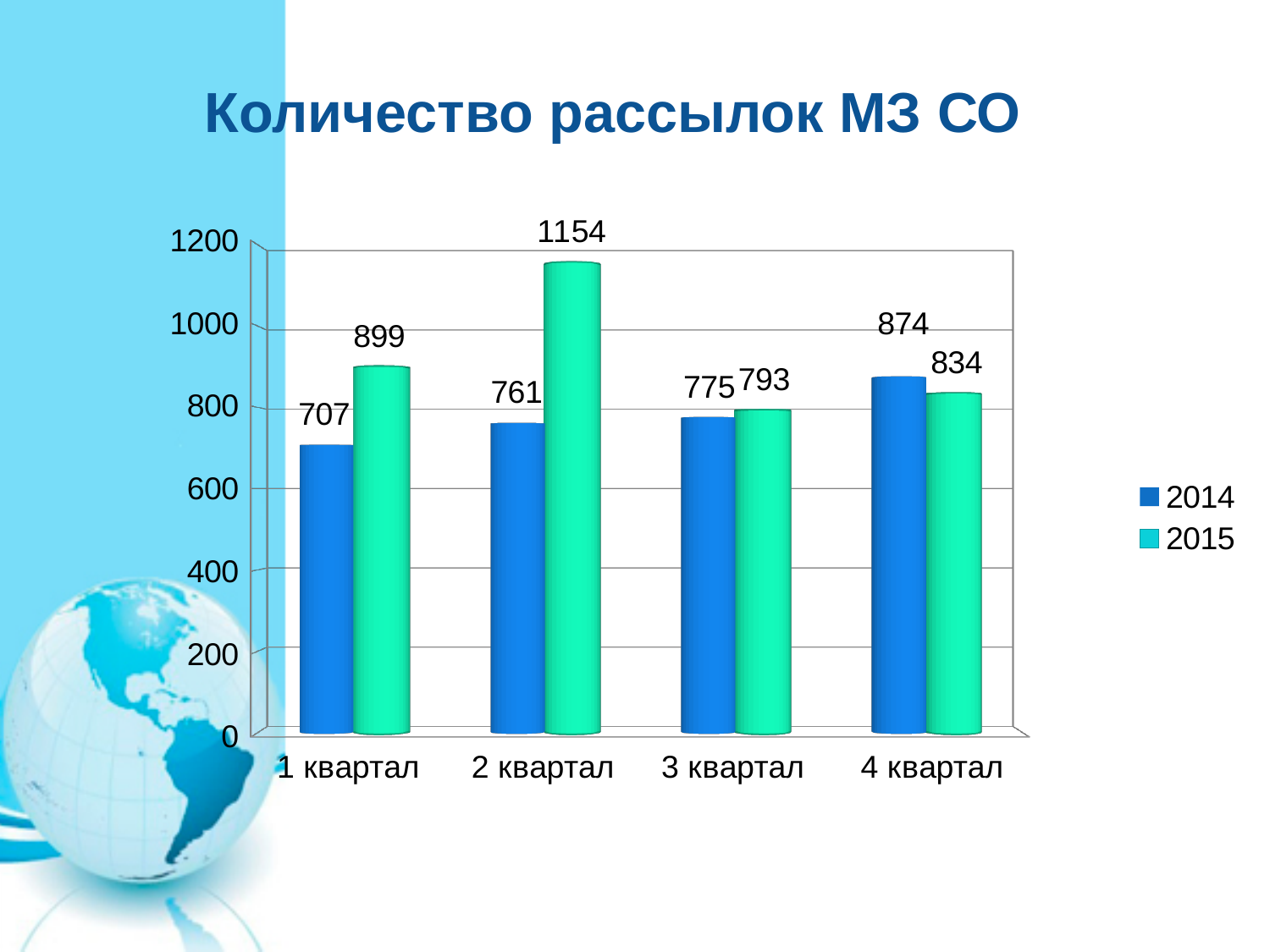
What kind of chart is shown on the slide? Bar chart What is the title of the chart? Количество рассылок МЗ СО What is the value for 2015 in 3 квартал? 793 What is the value for 2015 in 2 квартал? 1154 Which quarter has the lowest value for 2014? 1 квартал What is the value for 2014 in 4 квартал? 874 What is the value for 2014 in 1 квартал? 707 How many quarters (categories) are shown on the x axis? 4 Which quarter has the highest value for 2015? 2 квартал What is the difference between the 2015 and 2014 values in 2 квартал? 393 How many series does the legend list? 2 In 4 квартал, which series has the larger value, 2014 or 2015? 2014